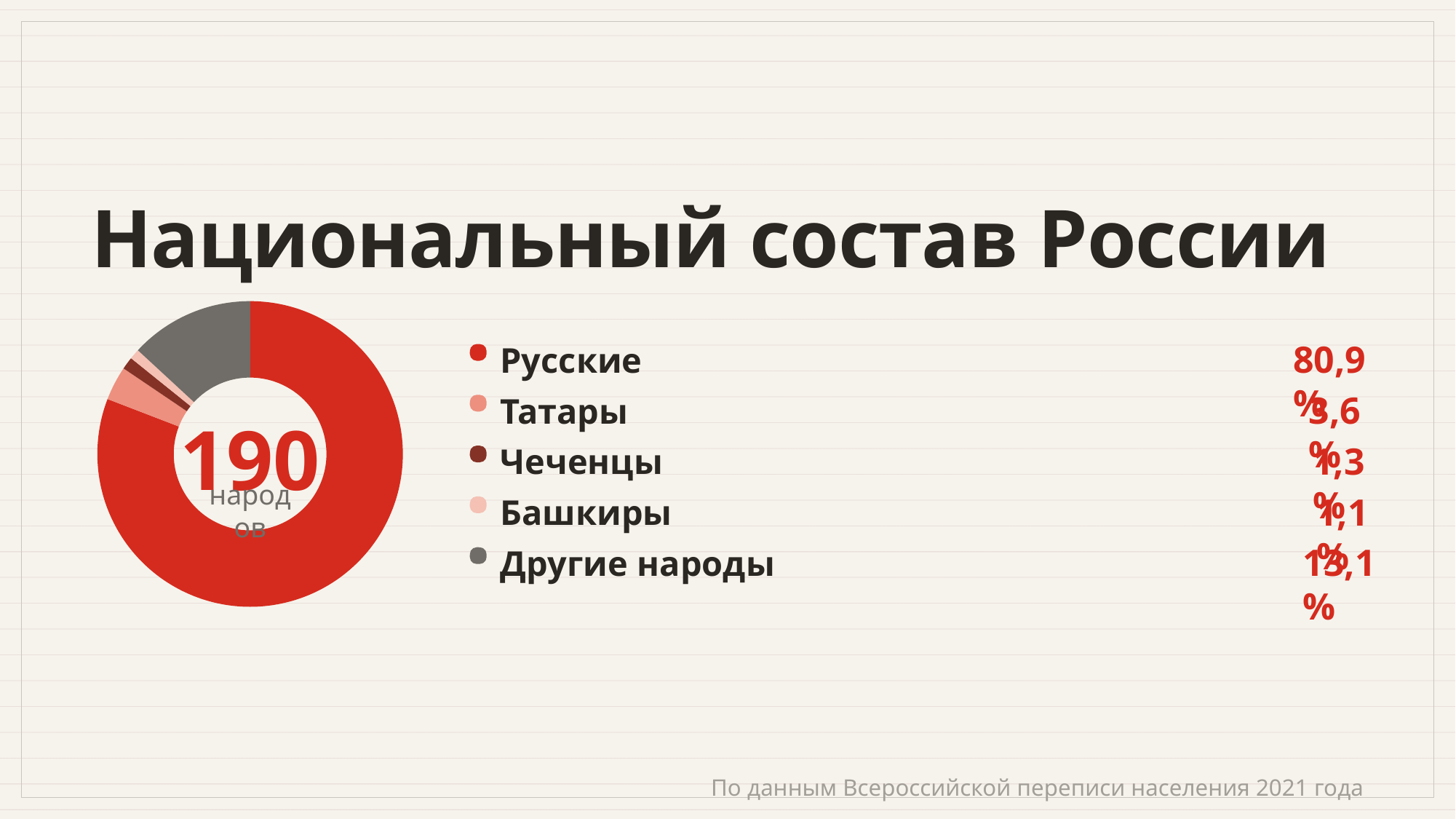
Which is larger, the share of Чеченцы or the share of Башкиры? Чеченцы What is the difference between the shares of Русские and Другие народы? 67,8% Which category has the smallest share in the chart? Башкиры What kind of chart is shown on the slide? Doughnut (pie) chart Which category has the largest share in the chart? Русские What share of the population is shown for Русские? 80,9% What number is displayed in the centre of the chart? 190 How many categories does the chart show? 5 What is the difference between the shares of Татары and Чеченцы? 2,3% What value is shown for Другие народы? 13,1% What value is shown for Татары? 3,6% What value is shown for Башкиры? 1,1%